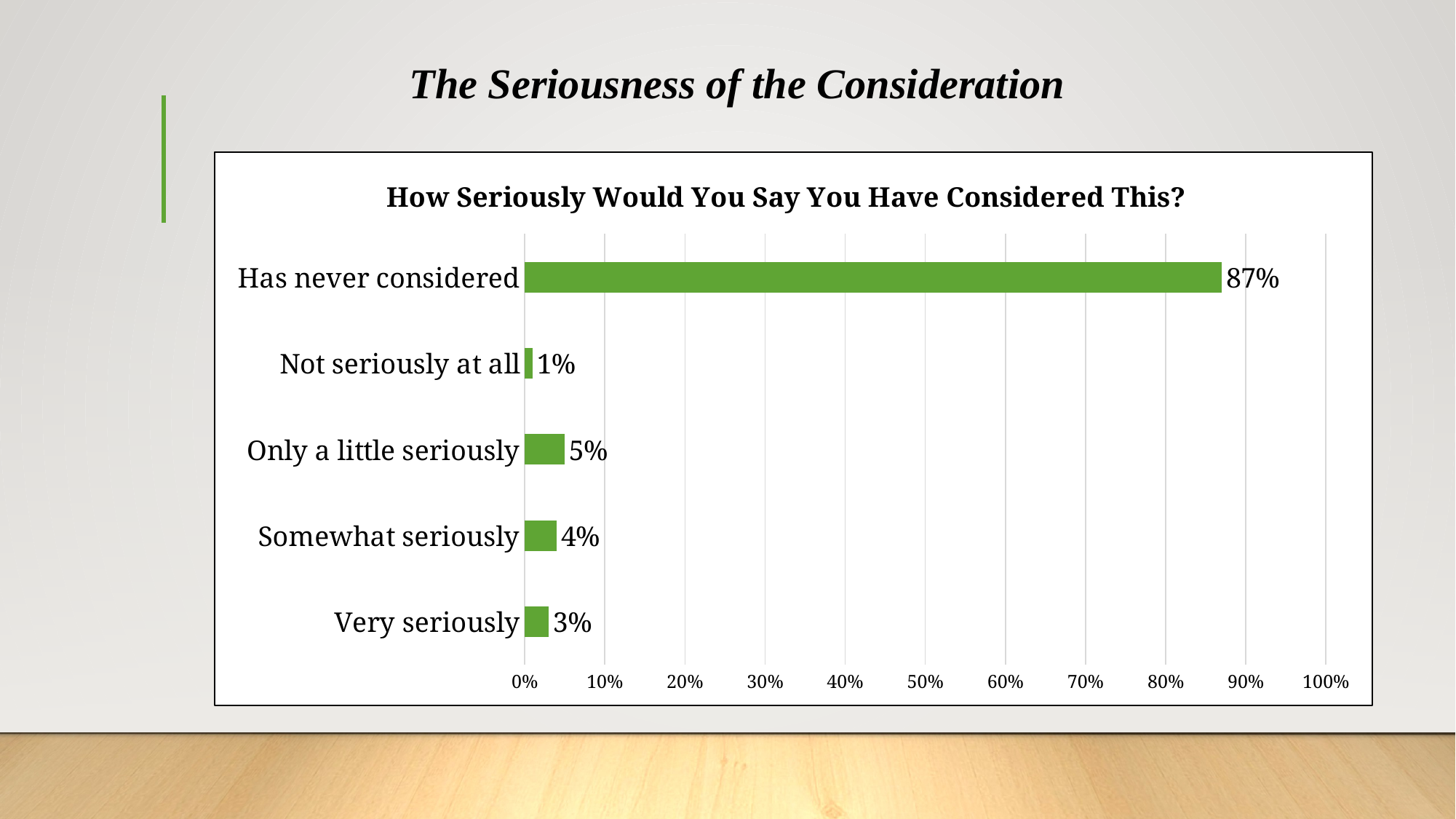
How many categories are shown in the chart? 5 What is the value for 'Only a little seriously'? 5% Which category has the highest value? Has never considered Is the value for 'Has never considered' greater or less than 80%? greater Which is larger, 'Somewhat seriously' or 'Very seriously'? Somewhat seriously What percentage of respondents has never considered this? 87% What is the value for 'Very seriously'? 3% What kind of chart is shown on the slide? Bar chart What is the difference between 'Has never considered' and 'Only a little seriously'? 82% What is the title of the chart? How Seriously Would You Say You Have Considered This? Which category has the lowest value? Not seriously at all What is the value for 'Somewhat seriously'? 4%